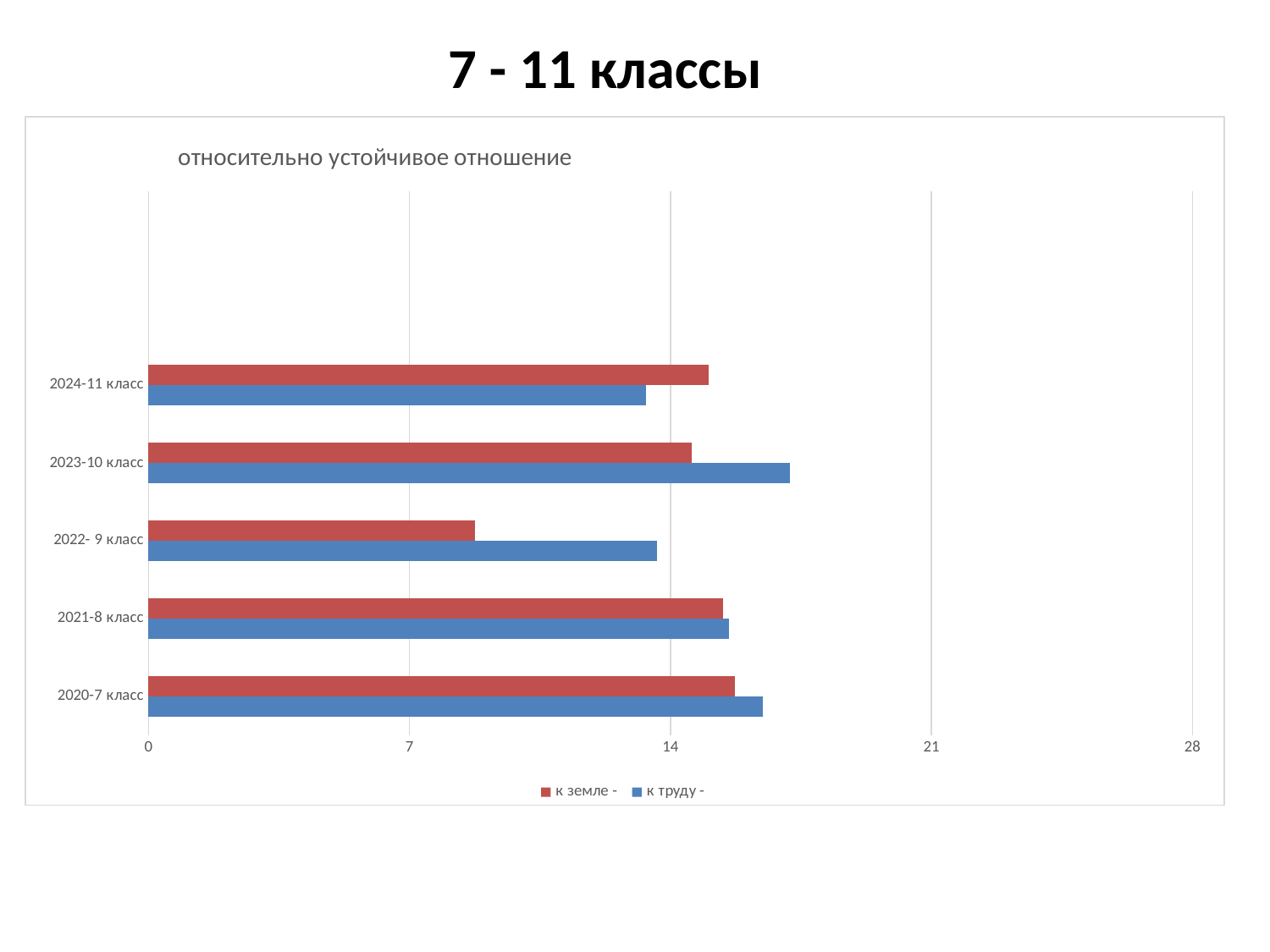
What kind of chart is shown on the slide? bar chart Which category has the lowest value for "к земле -"? 2022- 9 класс What is the title of the chart? относительно устойчивое отношение For 2024-11 класс, which is larger: "к земле -" or "к труду -"? к земле - Which category has the highest value for "к труду -"? 2023-10 класс How many series does the legend list? 2 For 2022- 9 класс, which is larger: "к земле -" or "к труду -"? к труду - Is the value for "к труду -" in 2023-10 класс greater or less than 14? greater Is the value for "к труду -" in 2024-11 класс greater or less than 14? less Is the value for "к земле -" in 2022- 9 класс greater or less than 14? less How many class categories are shown on the chart? 5 Which series is shown in red? к земле -